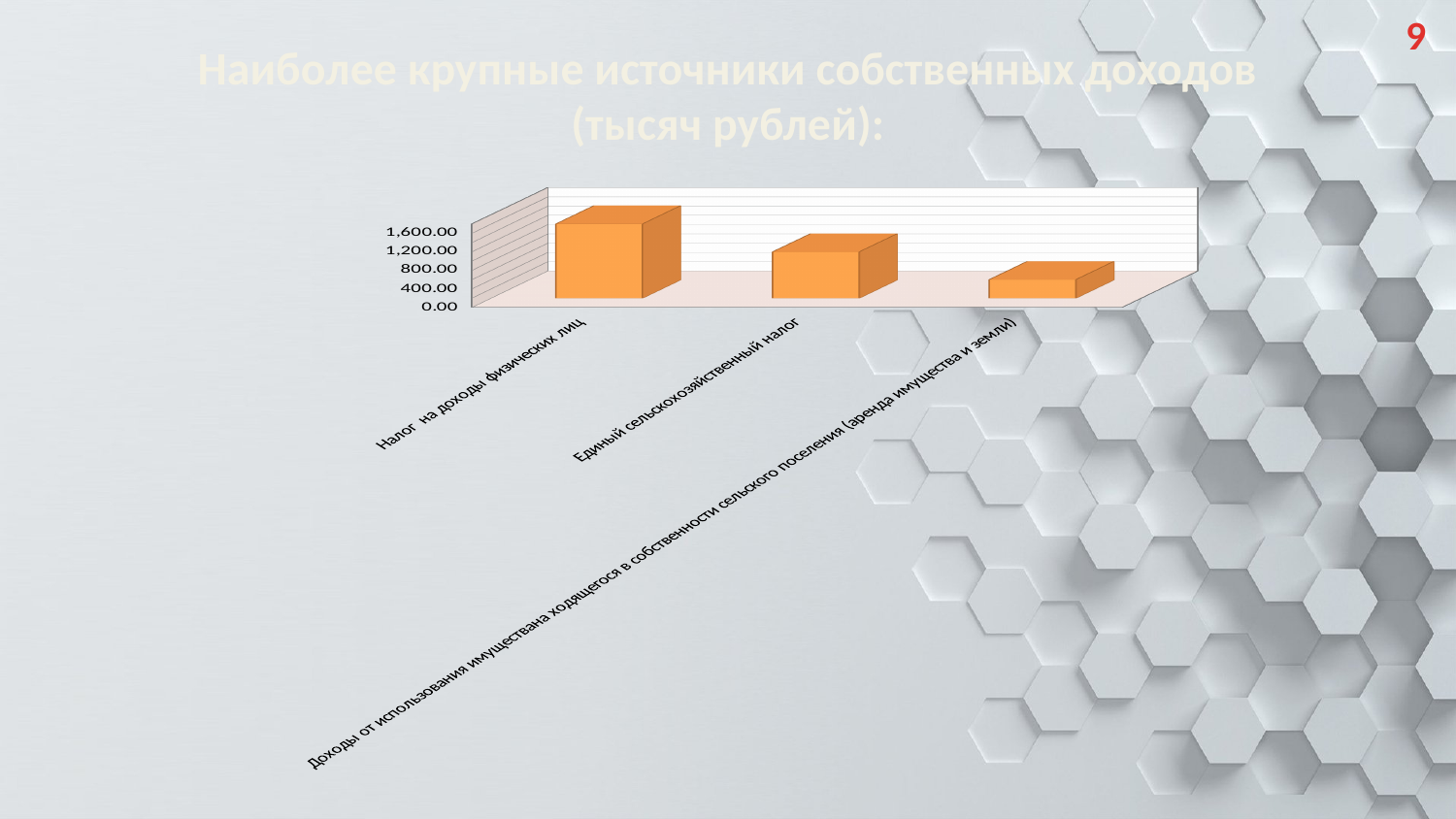
What is the title of the chart on the slide? Наиболее крупные источники собственных доходов (тысяч рублей): Do the values rise or fall from left to right across the categories? fall Which category has the lowest value in the chart? Доходы от использования имущества, находящегося в собственности сельского поселения (аренда имущества и земли) What colour are the bars in the chart? orange Is the value for Доходы от использования имущества (аренда имущества и земли) greater or less than 1,200? less Which is larger: the value for Налог на доходы физических лиц or the value for Единый сельскохозяйственный налог? Налог на доходы физических лиц Is the value for Налог на доходы физических лиц greater or less than 800? greater What kind of chart is shown on the slide? bar chart Is the value for Единый сельскохозяйственный налог greater or less than 400? greater Which is larger: the value for Единый сельскохозяйственный налог or the value for Доходы от использования имущества (аренда имущества и земли)? Единый сельскохозяйственный налог Which category has the highest value in the chart? Налог на доходы физических лиц How many categories are plotted in the chart? 3